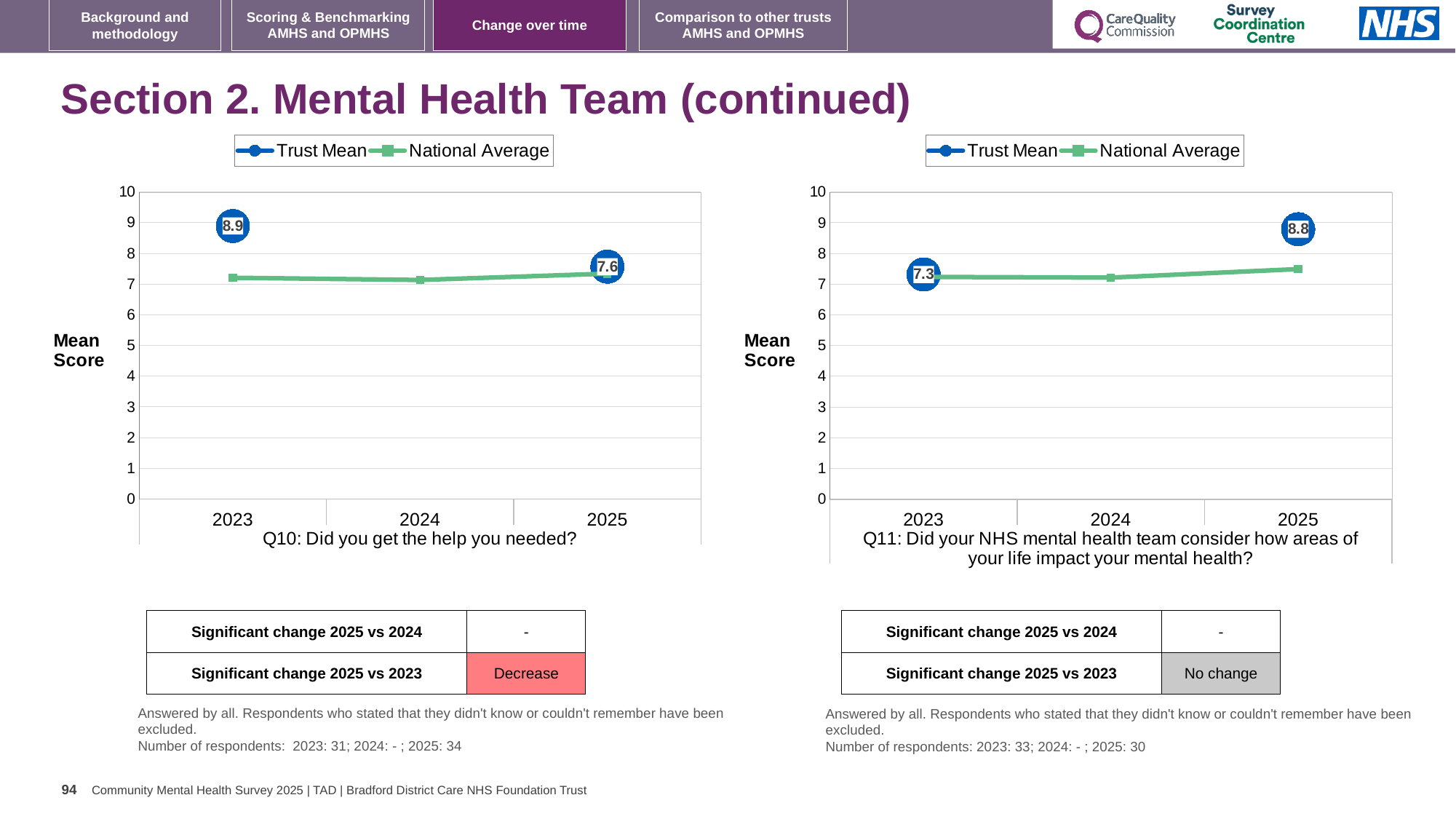
In the Q11 chart (right), by how much did the Trust Mean rise from 2023 to 2025? 1.5 In the Q10 chart (left), what is the Trust Mean for 2023? 8.9 What kind of chart is the Q11 chart (right)? line chart In the Q10 chart (left), is the National Average for 2024 greater or less than 8? less In the Q10 chart (left), what is the Trust Mean for 2025? 7.6 In the Q10 chart (left), by how much did the Trust Mean fall from 2023 to 2025? 1.3 In the Q11 chart (right), what is the Trust Mean for 2023? 7.3 In the Q11 chart (right), what is the Trust Mean for 2025? 8.8 How many years are shown on the x axis of the Q11 chart (right)? 3 How many series does the legend of the Q10 chart (left) list? 2 In the Q11 chart (right), is the Trust Mean for 2025 larger or smaller than the Trust Mean for 2023? larger In the Q10 chart (left), does the Trust Mean rise or fall from 2023 to 2025? fall